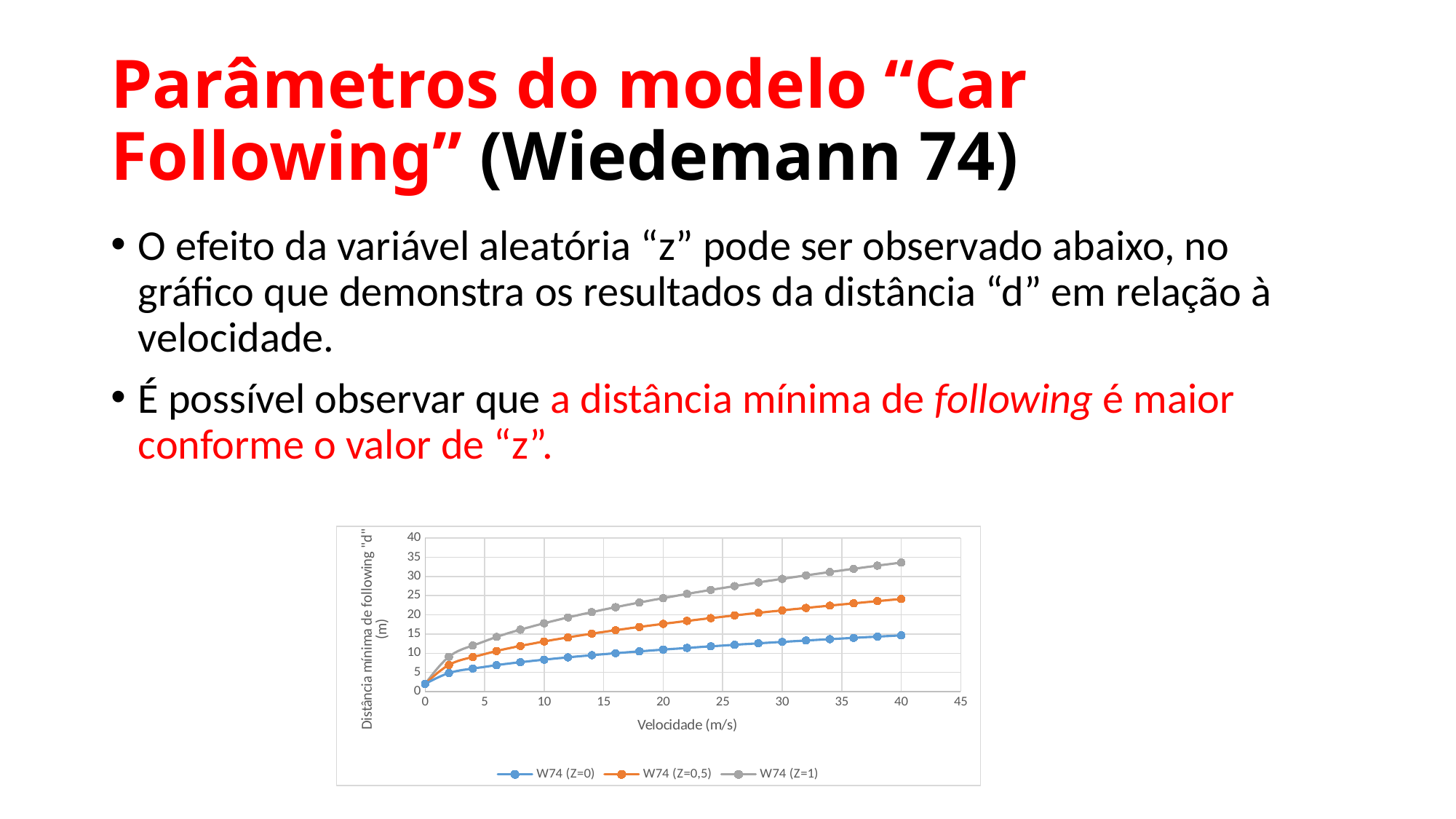
At a velocity of 40 m/s, is the value for W74 (Z=0) greater or less than 20? less How many series does the chart legend list? 3 What are the three legend entries of the chart? W74 (Z=0), W74 (Z=0,5), W74 (Z=1) What kind of chart is shown on the slide? line chart At a velocity of 40 m/s, is the value for W74 (Z=0,5) greater or less than 20? greater Which series reaches the highest value at a velocity of 40 m/s? W74 (Z=1) At a velocity of 20 m/s, is the value for W74 (Z=0) greater or less than 15? less Do the values of the W74 (Z=1) series rise or fall as velocity increases? rise What is the label of the x axis of the chart? Velocidade (m/s) Which series has the lowest values across the velocity range? W74 (Z=0) At a velocity of 30 m/s, which is larger: the value for W74 (Z=0,5) or the value for W74 (Z=0)? W74 (Z=0,5)